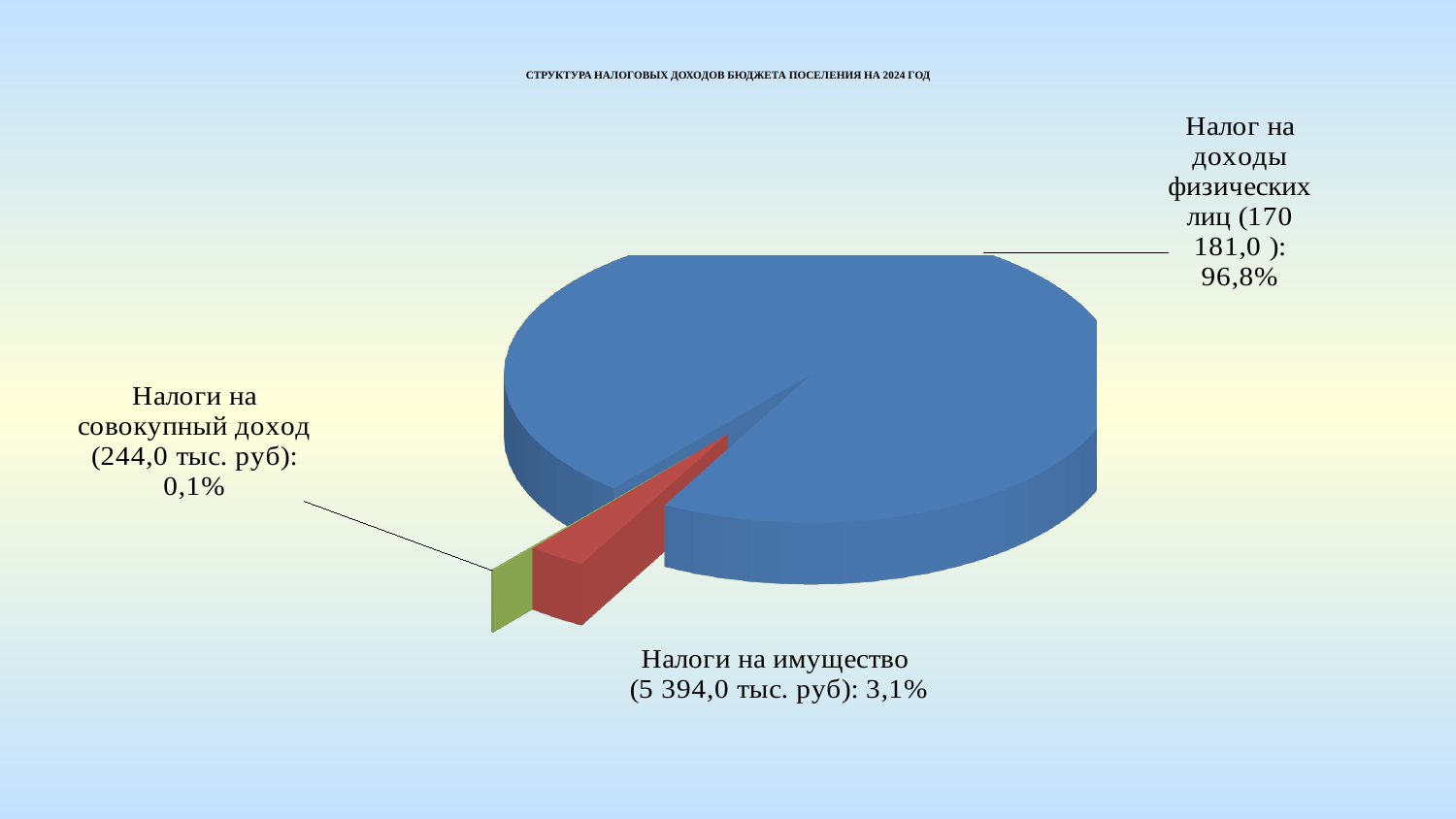
Какова доля налога на доходы физических лиц в структуре налоговых доходов? 96,8% Какая категория имеет наибольшую долю в структуре налоговых доходов? Налог на доходы физических лиц Какова доля налогов на совокупный доход? 0,1% Какая категория имеет наименьшую долю? Налоги на совокупный доход Сколько категорий показано на диаграмме? 3 Что больше: доля налогов на имущество или доля налогов на совокупный доход? Налоги на имущество Какая сумма указана для налогов на совокупный доход? 244,0 тыс. руб Какова доля налогов на имущество? 3,1% На сколько процентных пунктов доля налогов на имущество больше доли налогов на совокупный доход? 3,0 Какой тип диаграммы показан на слайде? Круговая диаграмма Какая сумма указана для налогов на имущество? 5 394,0 тыс. руб Какая сумма указана для налога на доходы физических лиц? 170 181,0